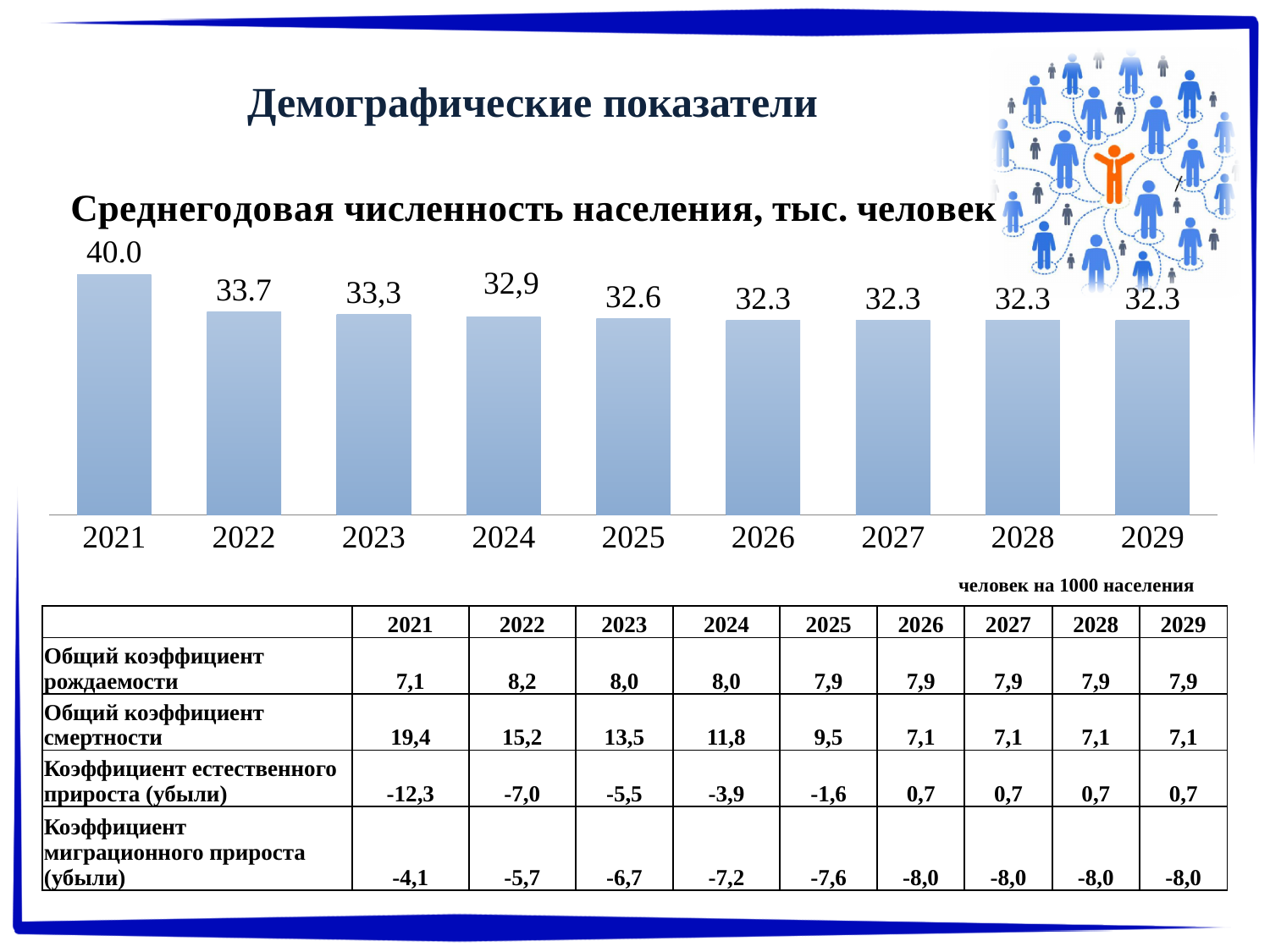
What is the value for 2024 in the bar chart? 32,9 What is the value for 2022 in the bar chart? 33.7 How many years are shown in the bar chart? 9 What kind of chart is used to show the average annual population? bar chart What is the value for 2029 in the bar chart? 32.3 What is the difference between the values for 2021 and 2022 in the bar chart? 6.3 Which year has the highest value in the bar chart? 2021 Which is larger in the bar chart, the value for 2022 or the value for 2025? 2022 What is the value for 2025 in the bar chart? 32.6 What is the difference between the values for 2021 and 2029 in the bar chart? 7.7 What is the value for 2023 in the bar chart? 33,3 What is the value for 2021 in the bar chart? 40.0